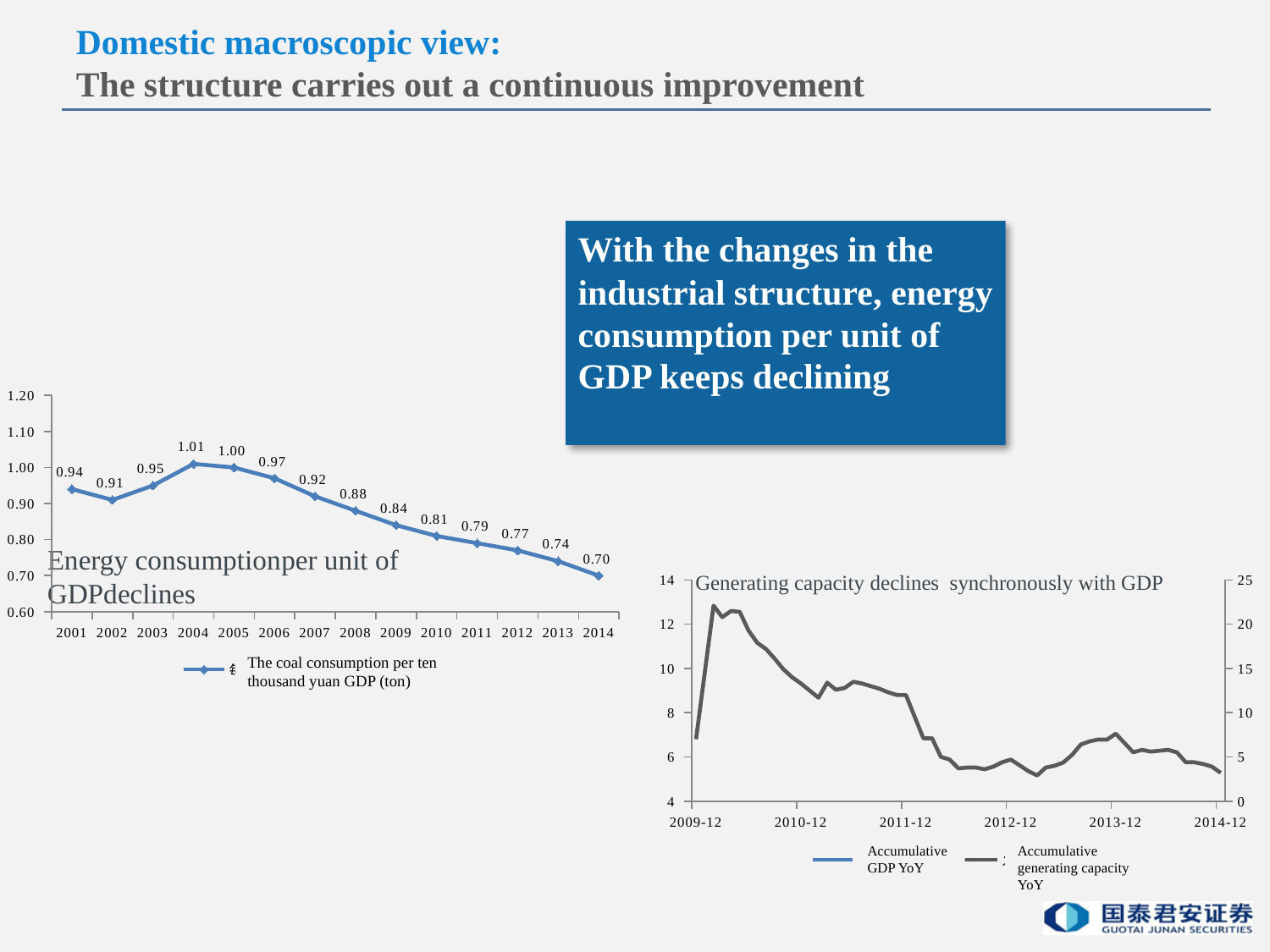
What kind of chart is the chart titled "Energy consumption per unit of GDP declines"? line chart In the chart titled "Energy consumption per unit of GDP declines", what is the value for 2004? 1.01 In the chart titled "Energy consumption per unit of GDP declines", which is larger, the value for 2001 or the value for 2002? 2001 In the chart titled "Energy consumption per unit of GDP declines", how many years are plotted? 14 In the chart titled "Energy consumption per unit of GDP declines", do the values rise or fall from 2005 to 2014? fall How many series does the legend of the chart titled "Generating capacity declines synchronously with GDP" list? 2 In the chart titled "Energy consumption per unit of GDP declines", which year has the lowest value? 2014 In the chart titled "Energy consumption per unit of GDP declines", which year has the highest value? 2004 In the chart titled "Energy consumption per unit of GDP declines", what is the value for 2009? 0.84 In the chart titled "Generating capacity declines synchronously with GDP", is the value of the plotted line at 2014-12 on the left axis greater or less than 6? less In the chart titled "Energy consumption per unit of GDP declines", what is the difference between the values for 2004 and 2014? 0.31 In the chart titled "Energy consumption per unit of GDP declines", what is the value for 2014? 0.70